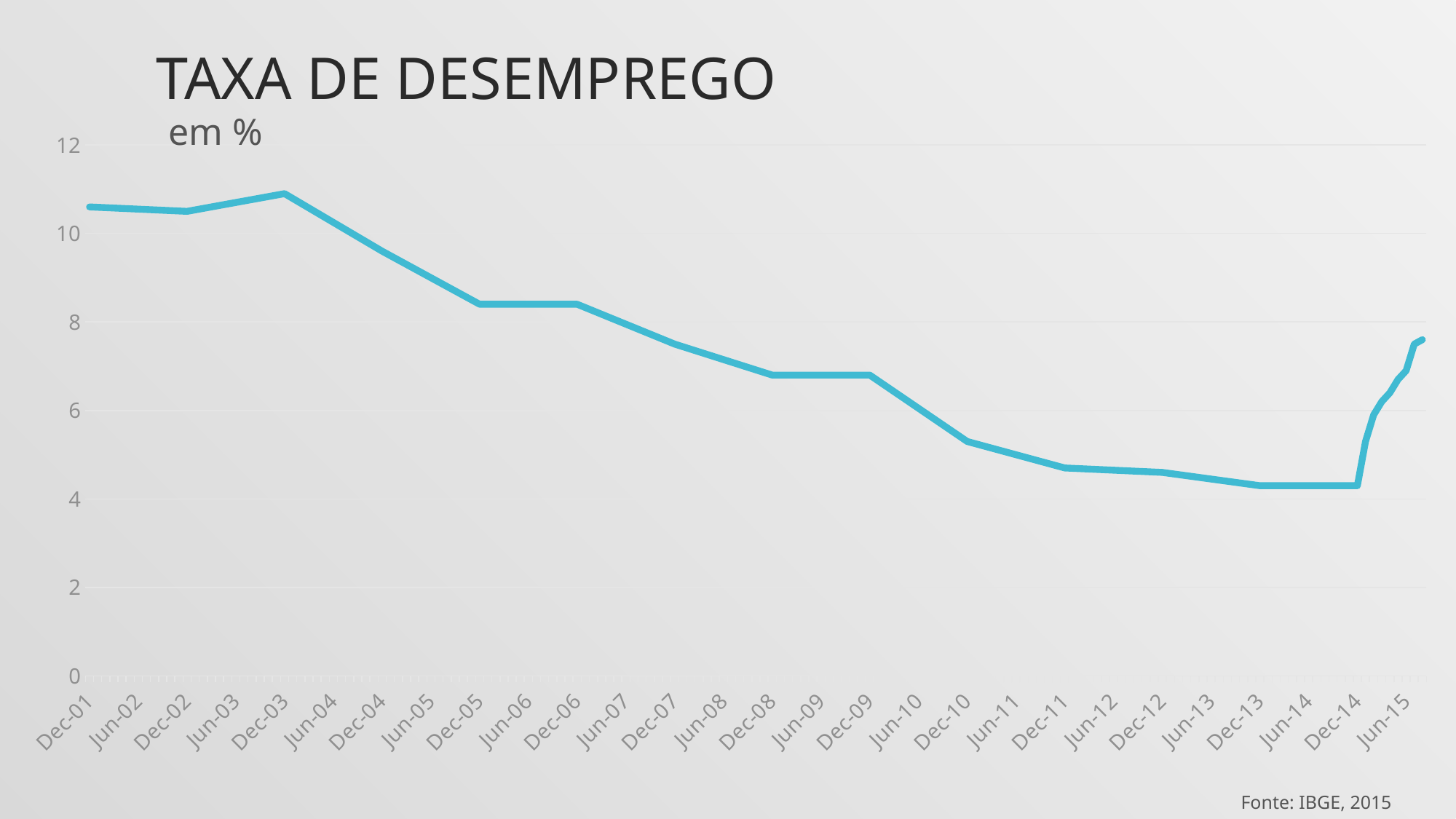
Is the value for Dec-08 greater or less than 8? less Is the value for Dec-14 greater or less than 6? less Between Dec-03 and Dec-14, does the line generally rise or fall? fall Is the value for Dec-10 greater or less than 6? less What is the source cited for the chart? IBGE, 2015 What kind of chart is shown on the slide? line chart At which x-axis label does the line reach its highest value? Dec-03 Between Dec-14 and Jun-15, does the line rise or fall? rise Which is larger, the value for Dec-01 or the value for Jun-15? Dec-01 What is the title of the chart? TAXA DE DESEMPREGO